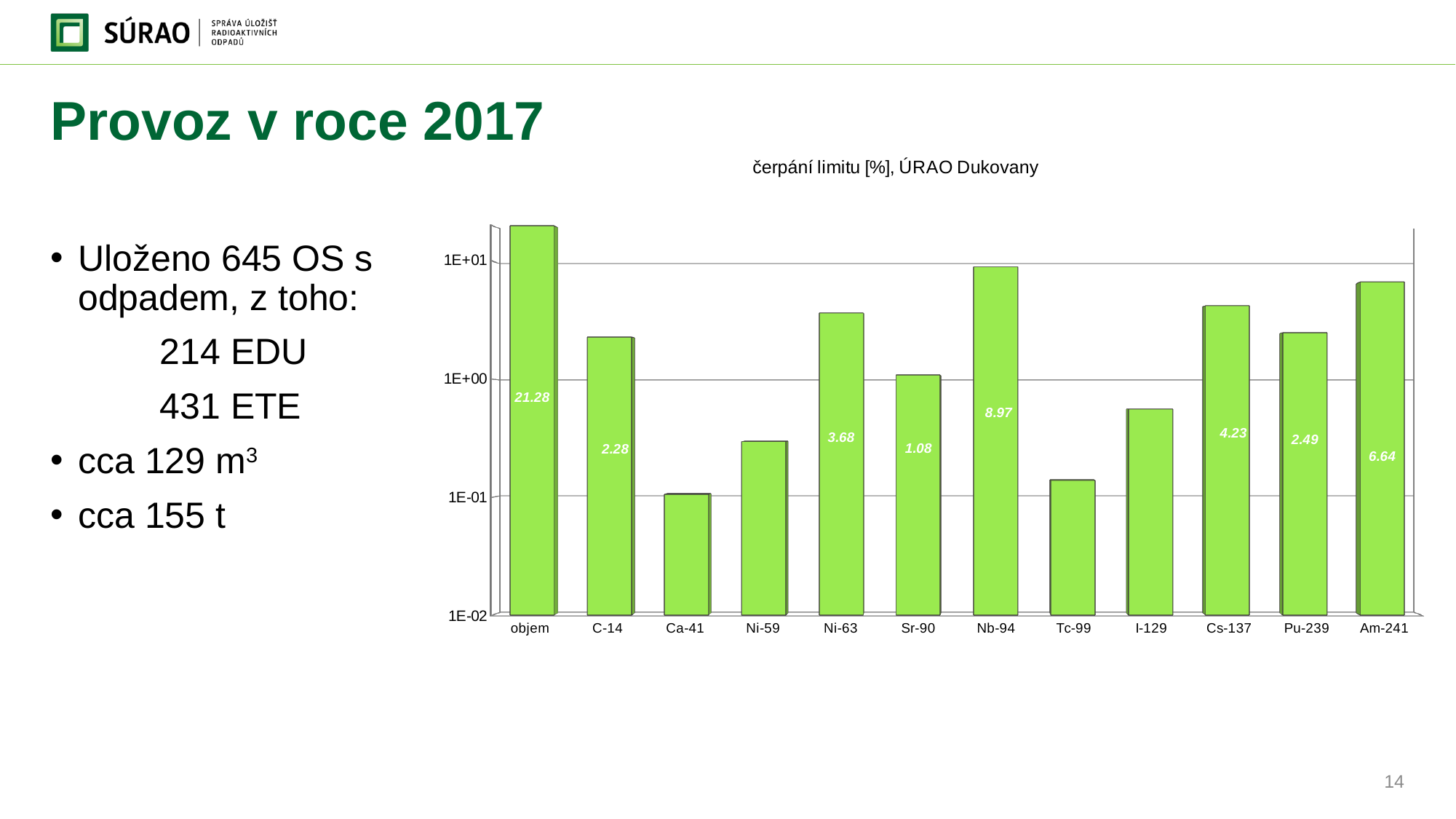
What is the value for Sr-90? 1.08 Is the value for Ni-59 greater or less than 1E+00? less What is the difference between the values for objem and Nb-94? 12.31 What is the value for objem? 21.28 What is the value for Nb-94? 8.97 Is the value for I-129 greater or less than 1E-01? greater What is the value for Am-241? 6.64 What type of chart is shown on the slide? bar chart Which category has the highest value? objem Which is larger, the value for Cs-137 or the value for Ni-63? Cs-137 Which category has the lowest value? Ca-41 How many categories are shown on the x axis? 12